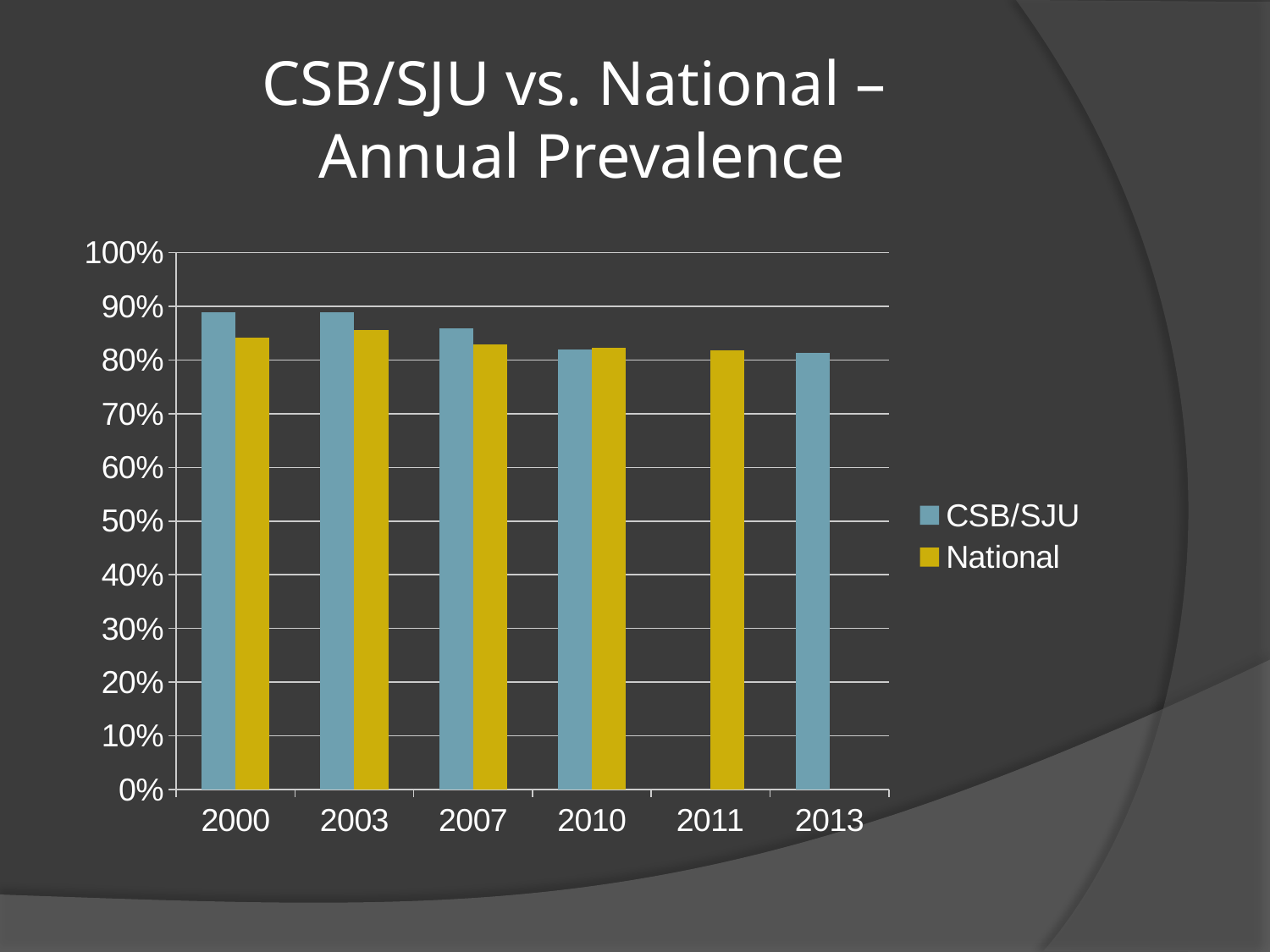
Is the CSB/SJU value for 2013 greater or less than 70%? greater What kind of chart is shown on the slide? bar chart In 2000, which is larger, the CSB/SJU value or the National value? CSB/SJU How many series does the legend list? 2 Is the CSB/SJU value for 2000 greater or less than 80%? greater Do the CSB/SJU values generally rise or fall from 2000 to 2013? fall Is the National value for 2011 greater or less than 90%? less Which series is shown in yellow? National What is the title of the chart? CSB/SJU vs. National – Annual Prevalence How many years are shown on the x axis? 6